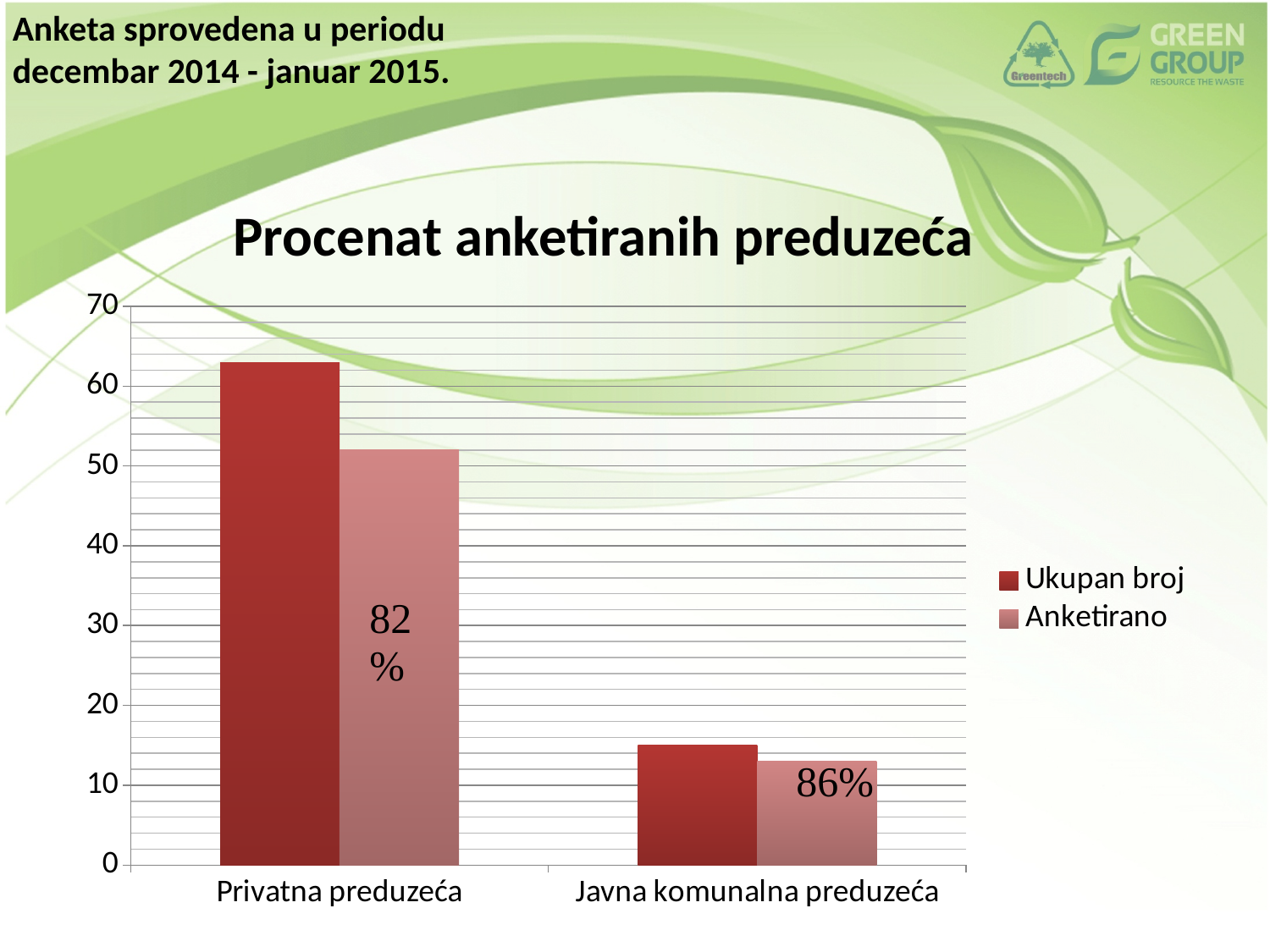
How many categories are shown on the x axis? 2 Which category has the highest value for Ukupan broj? Privatna preduzeća What percentage label is printed on the Anketirano bar for Javna komunalna preduzeća? 86% For Privatna preduzeća, which is larger: Ukupan broj or Anketirano? Ukupan broj Is the Anketirano value for Privatna preduzeća greater or less than 60? less How many series does the legend list? 2 Which series is shown in the darker red colour? Ukupan broj Which category has the lowest value for Anketirano? Javna komunalna preduzeća What is the title of the chart? Procenat anketiranih preduzeća Is the Ukupan broj value for Privatna preduzeća greater or less than 60? greater Is the Ukupan broj value for Javna komunalna preduzeća greater or less than 20? less What kind of chart is shown on the slide? bar chart